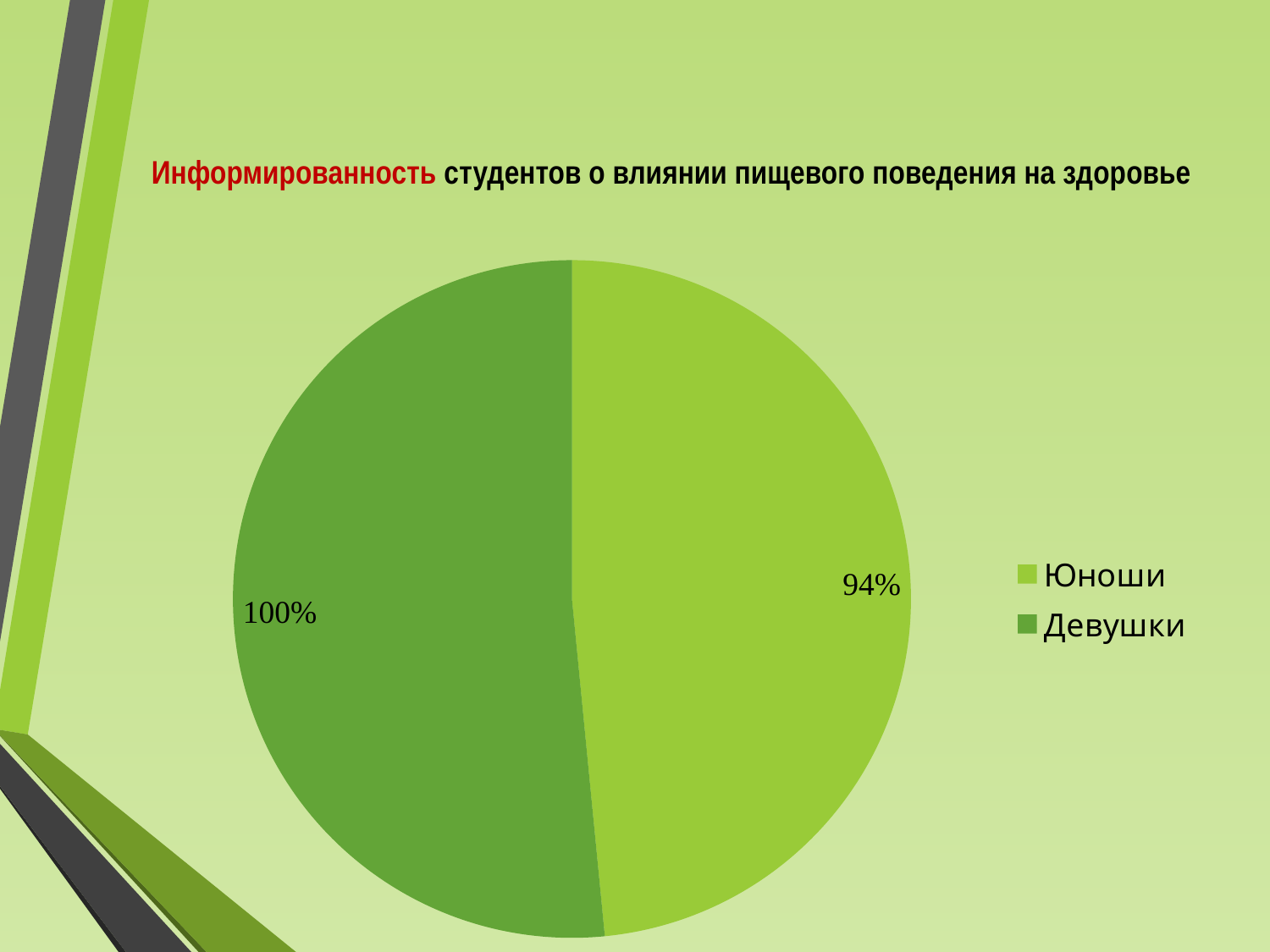
What value is shown for Юноши on the pie chart? 94% What is the title of the slide above the chart? Информированность студентов о влиянии пищевого поведения на здоровье What value is shown for Девушки on the pie chart? 100% Which legend entry is shown in the darker green colour? Девушки How many entries does the legend list? 2 How many categories (slices) does the pie chart have? 2 What is the difference between the values for Девушки and Юноши? 6% Which category has the lowest value on the chart? Юноши What kind of chart is shown on the slide? Pie chart Which category has the higher value, Юноши or Девушки? Девушки Which category has the highest value on the chart? Девушки